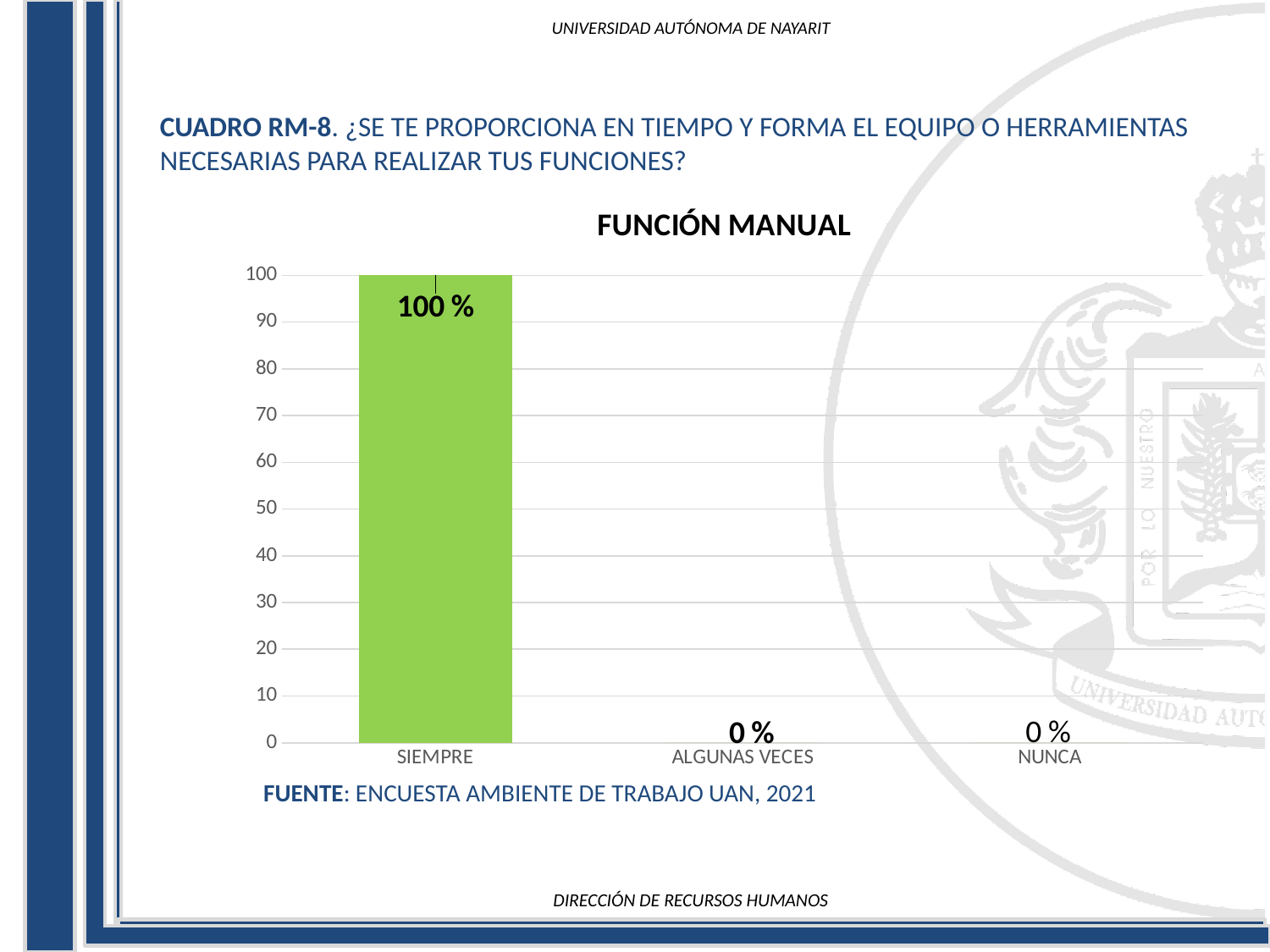
Which category has the highest value? SIEMPRE How many categories are shown on the x axis? 3 What is the difference between the values for SIEMPRE and ALGUNAS VECES? 100 % What is the value for SIEMPRE? 100 % Is the value for SIEMPRE greater or less than 50? greater What is the value for NUNCA? 0 % What is the value for ALGUNAS VECES? 0 % Which is larger, the value for SIEMPRE or the value for NUNCA? SIEMPRE What is the title of the chart? FUNCIÓN MANUAL What kind of chart is shown? bar chart Do the values rise or fall from SIEMPRE to NUNCA along the x axis? fall What colour is the bar for SIEMPRE? green